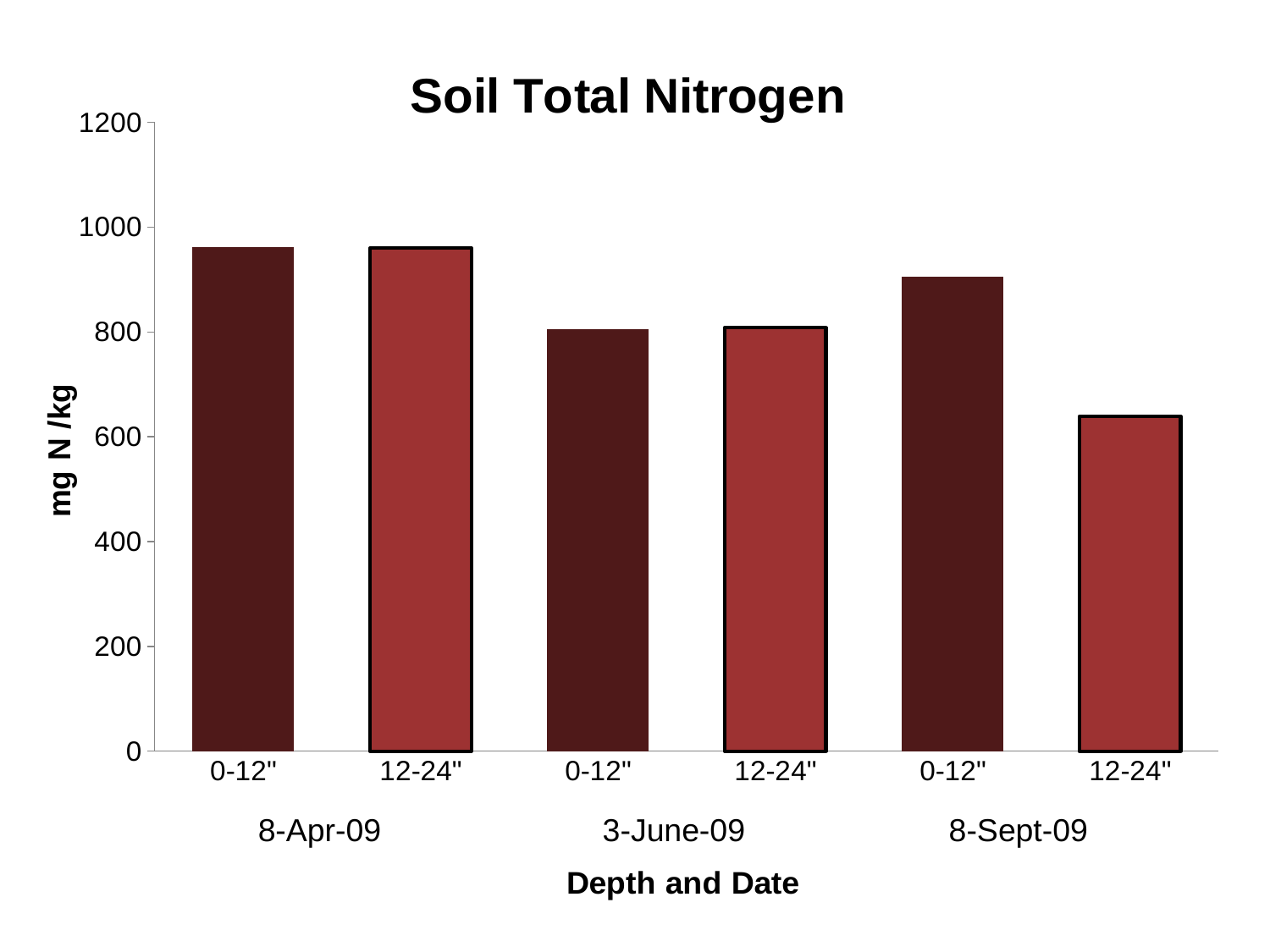
How many bars are plotted in the chart? 6 For the 0-12" depth, which date has the larger value, 8-Apr-09 or 3-June-09? 8-Apr-09 Is the value for the 12-24" depth on 8-Sept-09 greater or less than 800? less Which bar has the lowest soil total nitrogen value? 12-24" on 8-Sept-09 Is the value for the 0-12" depth on 8-Apr-09 greater or less than 1000? less What is the title of the chart? Soil Total Nitrogen Is the value for the 0-12" depth on 3-June-09 greater or less than 600? greater What kind of chart is shown on the slide? bar chart What is the label on the vertical axis? mg N /kg On 8-Sept-09, which depth has the larger soil total nitrogen value, 0-12" or 12-24"? 0-12" How many sampling dates are shown along the x axis? 3